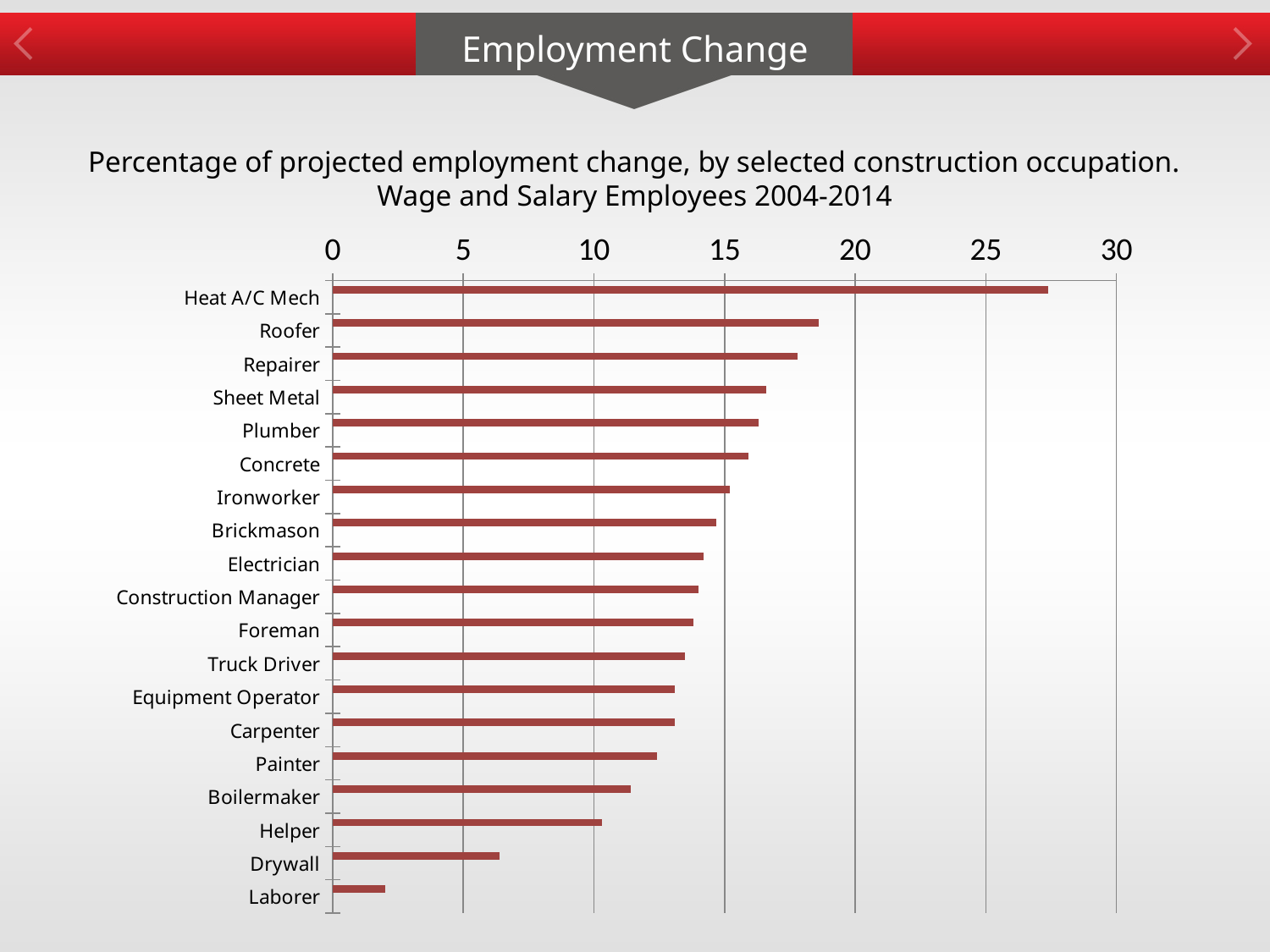
Is the value for Heat A/C Mech greater or less than 25? greater Is the value for Drywall greater or less than 5? greater How many occupations are plotted in the chart? 19 Which occupation has the lowest projected employment change? Laborer What is the highest value shown on the horizontal axis? 30 Is the value for Roofer greater or less than 20? less Which has a larger projected employment change, Drywall or Laborer? Drywall Which has a larger projected employment change, Heat A/C Mech or Roofer? Heat A/C Mech What kind of chart is shown on the slide? Bar chart Which occupation has the highest projected employment change? Heat A/C Mech